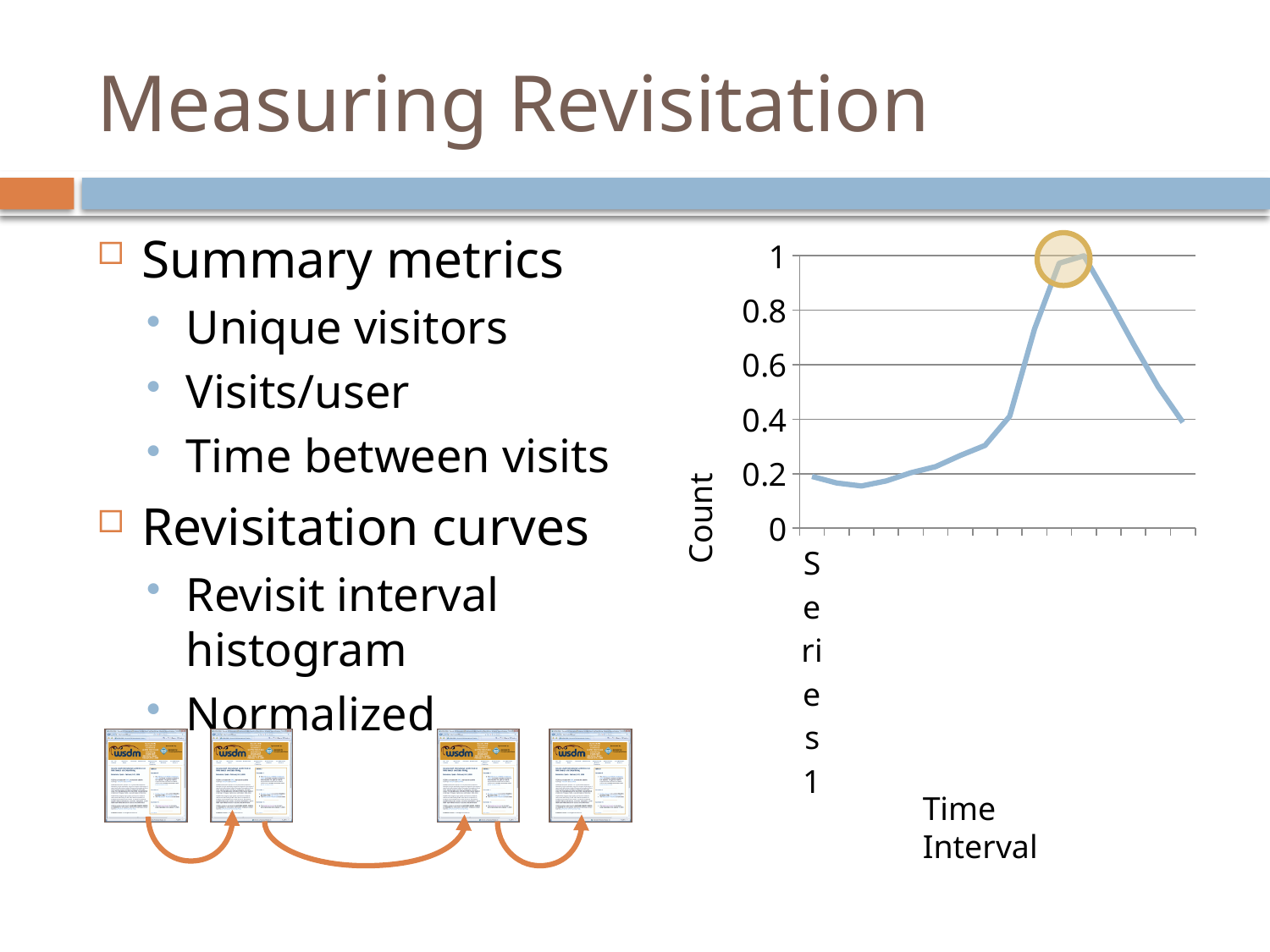
Is the last value on the line greater or less than 0.6? less Is the lowest value on the line greater or less than 0.2? less Is the last value on the line greater or less than 0.2? greater What is the title of the horizontal axis of the chart? Time Interval Does the line rise or fall from its peak to the right end of the chart? fall What is the title of the vertical axis of the chart? Count What kind of chart is shown on the right of the slide? line chart How many series does the chart plot? 1 What is the highest value labelled on the vertical axis? 1 Does the line generally rise or fall from the left end of the chart up to its peak? rise